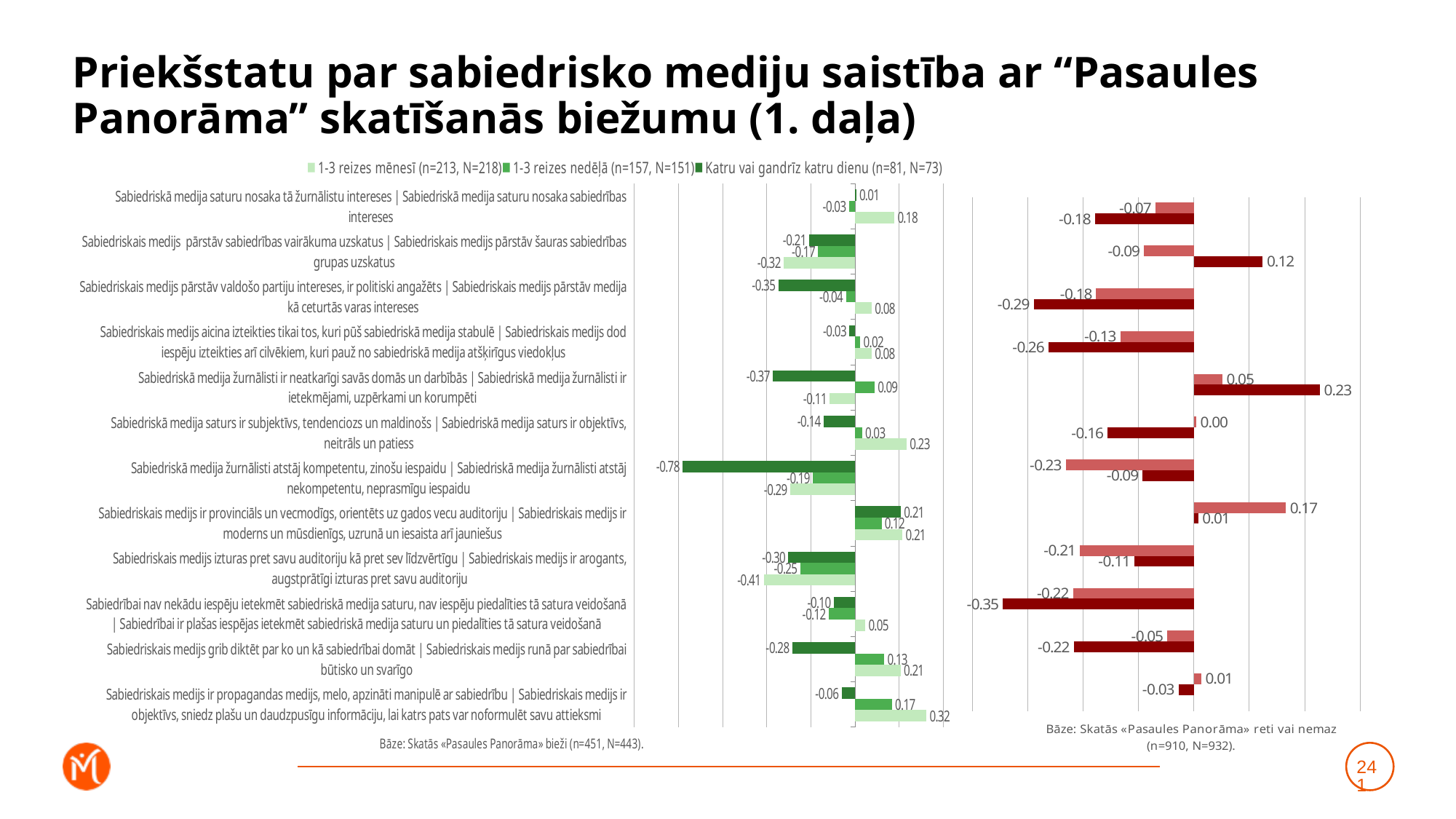
In the right chart, what is the highest value shown? 0.23 What kind of chart is the left chart? Bar chart In the right chart, what is the lowest value shown? -0.35 In the left chart, what is the value for '1-3 reizes mēnesī' for the category 'Sabiedriskā medija saturu nosaka tā žurnālistu intereses | Sabiedriskā medija saturu nosaka sabiedrības intereses'? 0.18 In the left chart, what is the value for '1-3 reizes nedēļā' for the category 'Sabiedriskais medijs ir propagandas medijs, melo, apzināti manipulē ar sabiedrību | Sabiedriskais medijs ir objektīvs, sniedz plašu un daudzpusīgu informāciju, lai katrs pats var noformulēt savu attieksmi'? 0.17 In the left chart, for the category 'Sabiedriskais medijs grib diktēt par ko un kā sabiedrībai domāt | Sabiedriskais medijs runā par sabiedrībai būtisko un svarīgo', which is larger: the '1-3 reizes mēnesī' value or the '1-3 reizes nedēļā' value? 1-3 reizes mēnesī In the left chart, what is the value for 'Katru vai gandrīz katru dienu' for the category 'Sabiedriskā medija žurnālisti atstāj kompetentu, zinošu iespaidu | Sabiedriskā medija žurnālisti atstāj nekompetentu, neprasmīgu iespaidu'? -0.78 How many series does the legend of the left chart list? 3 In the left chart, what is the difference between the '1-3 reizes nedēļā' value (-0.25) and the '1-3 reizes mēnesī' value (-0.41) for the category 'Sabiedriskais medijs izturas pret savu auditoriju kā pret sev līdzvērtīgu | Sabiedriskais medijs ir arogants, augstprātīgi izturas pret savu auditoriju'? 0.16 In the left chart, which category has the lowest value for the 'Katru vai gandrīz katru dienu' series? Sabiedriskā medija žurnālisti atstāj kompetentu, zinošu iespaidu | Sabiedriskā medija žurnālisti atstāj nekompetentu, neprasmīgu iespaidu How many categories are shown in the left chart? 12